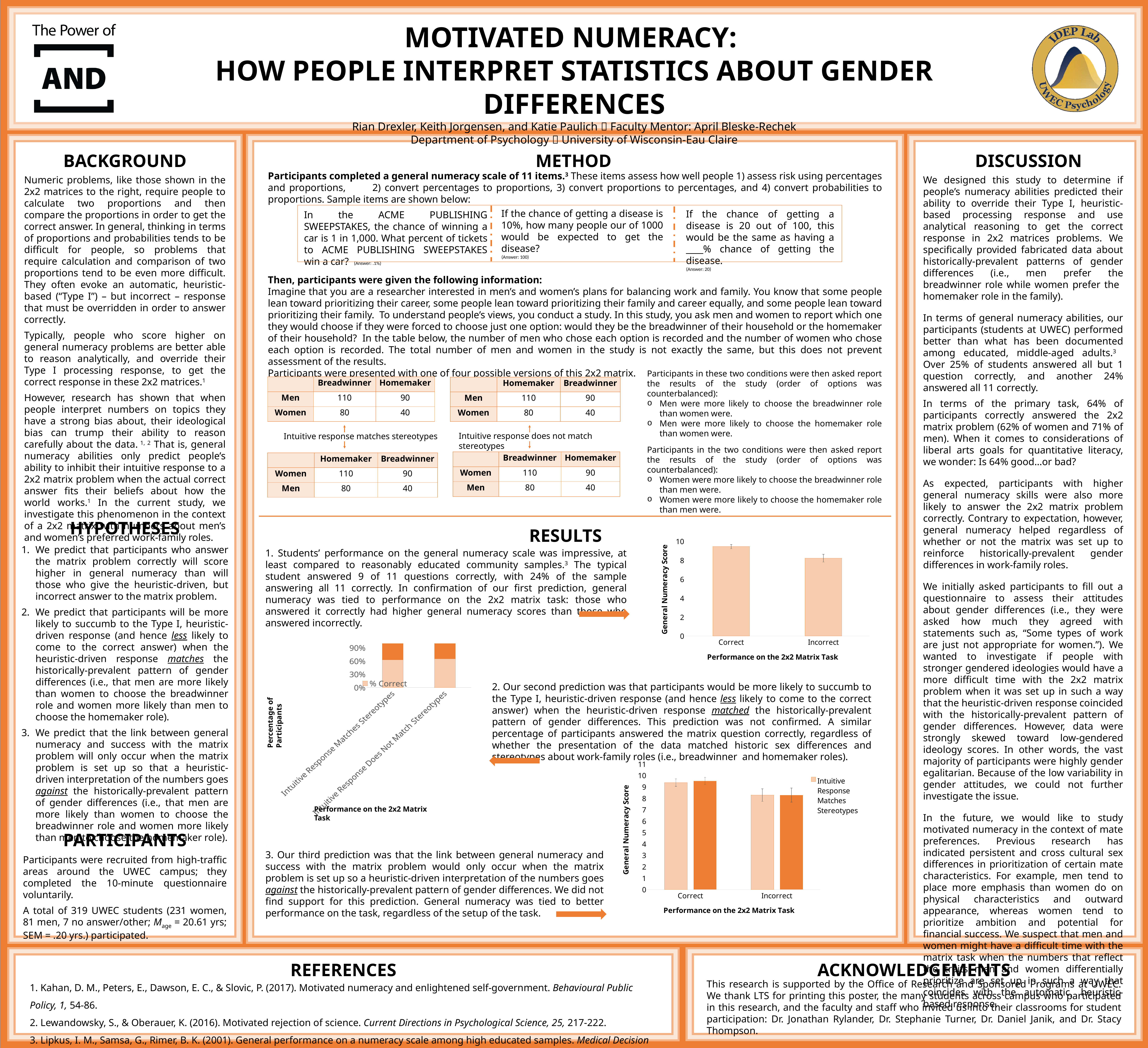
In the bottom-right Results chart (y-axis 0 to 11), is the General Numeracy Score for the lighter bar in the Correct category greater or less than 8? greater In the top-right Results chart (General Numeracy Score, y-axis 0 to 10), how many categories are shown on the x-axis? 2 In the top-right Results chart (y-axis 0 to 10), which category has the higher General Numeracy Score, Correct or Incorrect? Correct In the top-right Results chart (y-axis 0 to 10), is the General Numeracy Score for Correct greater or less than 8? greater In the stacked bar chart on the left of the Results section (Percentage of Participants), how many categories are shown on the x-axis? 2 In the chart at the top right of the Results section, what kind of chart is used to show General Numeracy Score by performance on the 2x2 matrix task? bar chart In the top-right Results chart (y-axis 0 to 10), is the General Numeracy Score for Incorrect greater or less than 6? greater In the stacked bar chart on the left of the Results section (Percentage of Participants), what is the highest percentage tick shown on the y-axis? 90% In the bottom-right Results chart (General Numeracy Score, y-axis 0 to 11), how many bars are plotted in total? 4 In the bottom-right Results chart (y-axis 0 to 11), do the General Numeracy Scores rise or fall going from Correct to Incorrect? fall In the top-right Results chart (y-axis 0 to 10), what is the x-axis title? Performance on the 2x2 Matrix Task